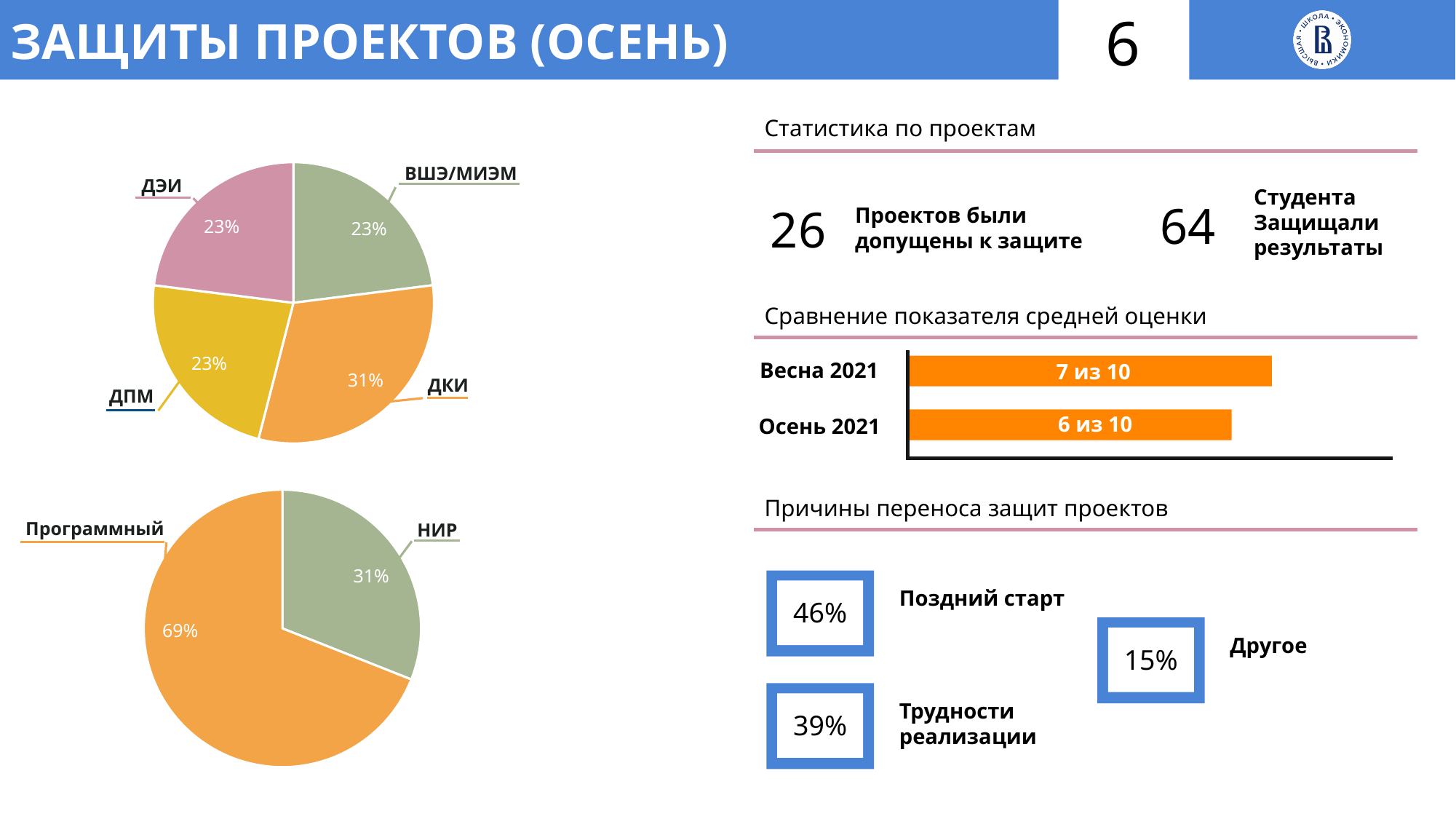
In the top-left pie chart, what share does ВШЭ/МИЭМ have? 23% In the bottom-left pie chart, what share does НИР have? 31% In the bottom-left pie chart, which is larger: Программный or НИР? Программный In the chart titled 'Сравнение показателя средней оценки', which period has the lower value? Осень 2021 How many slices does the top-left pie chart have? 4 In the chart titled 'Сравнение показателя средней оценки', what is the value for Весна 2021? 7 из 10 In the top-left pie chart, what is the difference between the ДКИ share and the ДПМ share? 8% In the bottom-left pie chart, what share does Программный have? 69% In the top-left pie chart, which category has the largest slice? ДКИ How many slices does the bottom-left pie chart have? 2 What kind of chart is 'Сравнение показателя средней оценки'? bar chart In the top-left pie chart, what share does ДКИ have? 31%